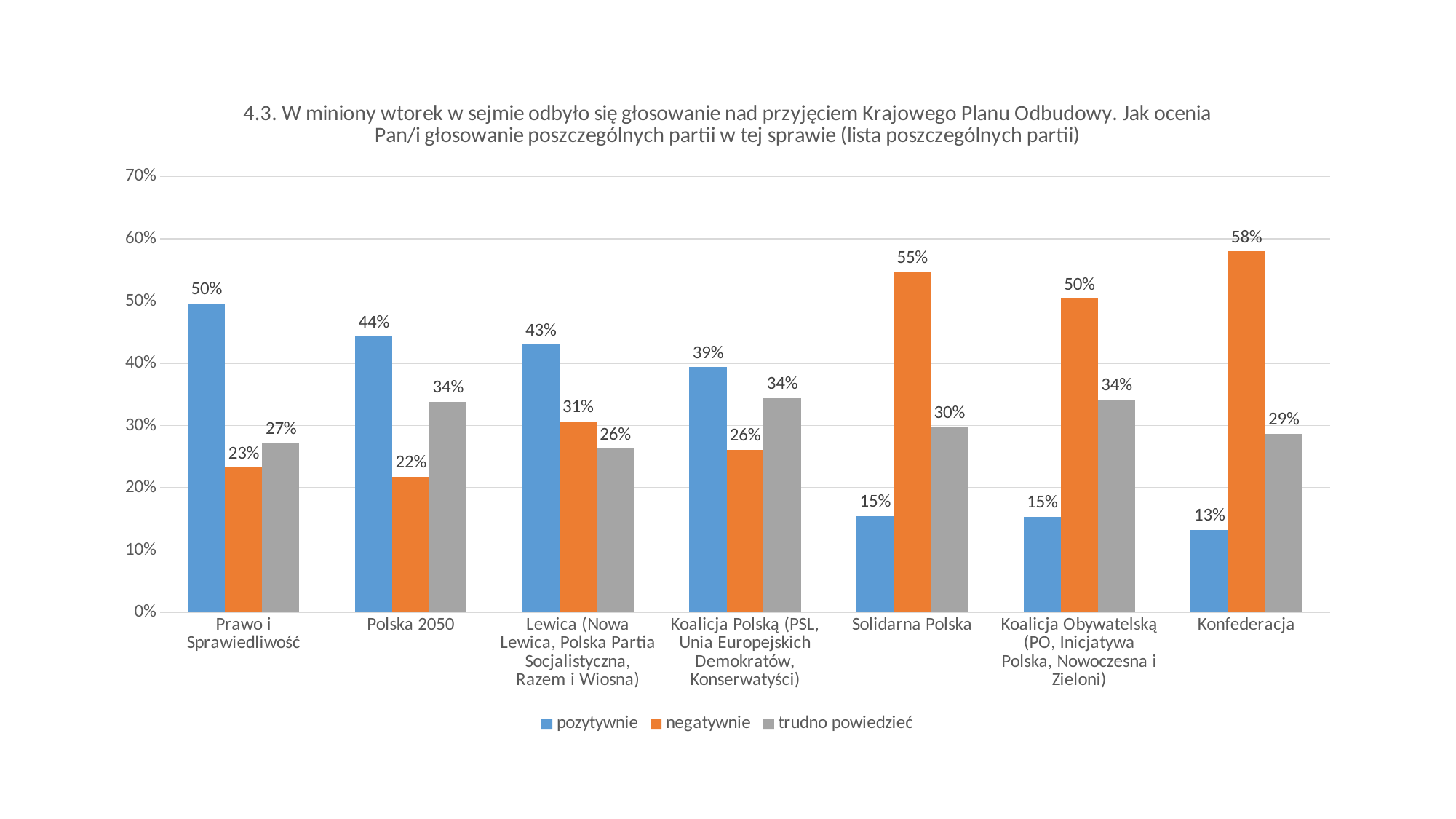
What is the difference between the 'pozytywnie' and 'negatywnie' values for Polska 2050? 22% What kind of chart is shown on the slide? bar chart How many series does the legend list? 3 How many parties are shown on the x axis? 7 What is the 'negatywnie' value for Konfederacja? 58% Which is larger for Lewica: the 'negatywnie' value or the 'trudno powiedzieć' value? negatywnie Which colour represents the 'negatywnie' series? orange Which party has the lowest 'pozytywnie' value? Konfederacja What is the 'pozytywnie' value for Prawo i Sprawiedliwość? 50% Which party has the highest 'negatywnie' value? Konfederacja Is the 'negatywnie' value for Solidarna Polska greater or less than 50%? greater What is the 'trudno powiedzieć' value for Solidarna Polska? 30%